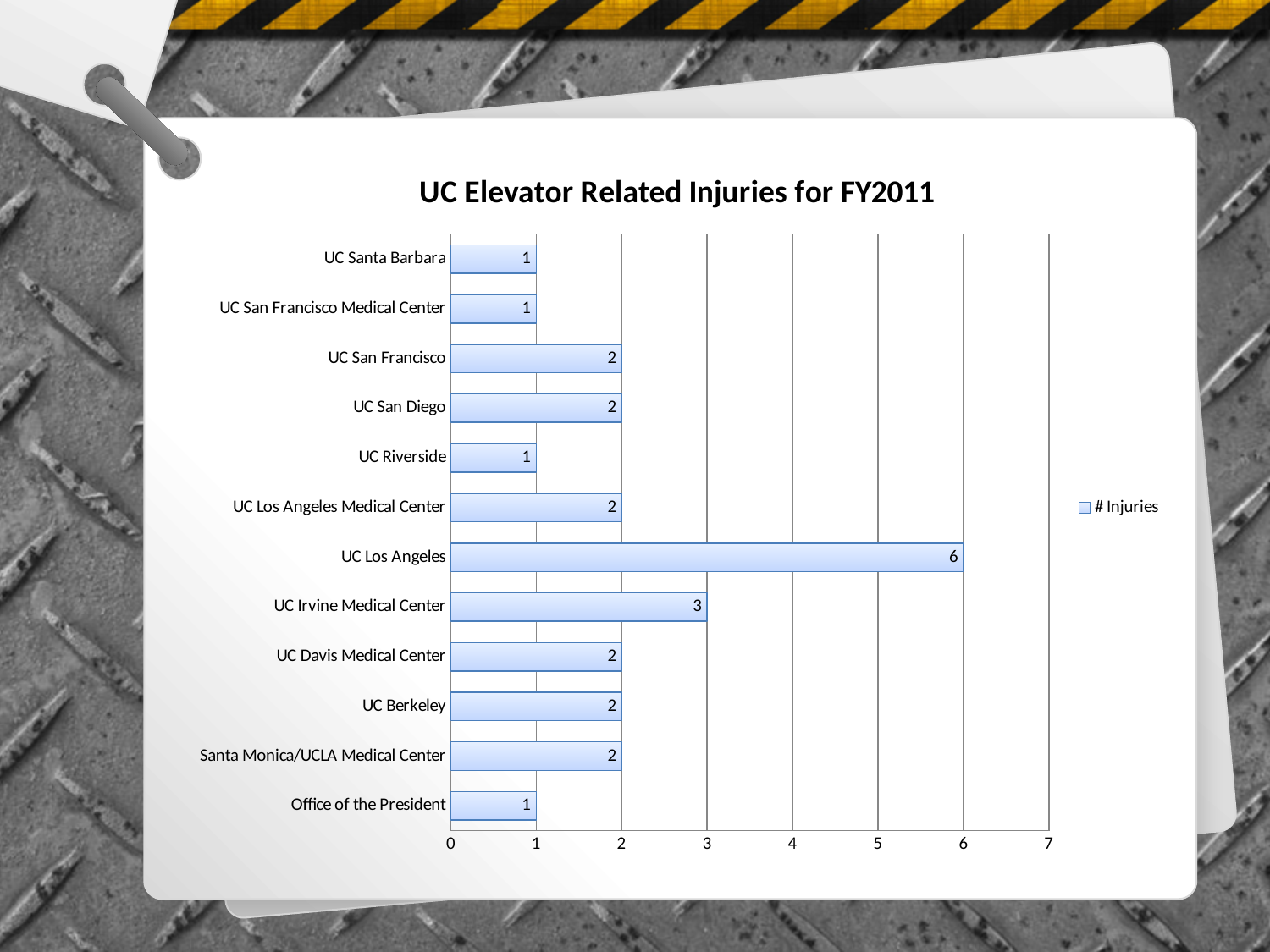
What kind of chart is shown on the slide? bar chart Which has more injuries, UC San Diego or UC Riverside? UC San Diego Is the value for UC Los Angeles greater or less than 5? greater What is the legend entry shown on the chart? # Injuries What is the difference in injuries between UC Los Angeles and UC Irvine Medical Center? 3 How many series does the legend list? 1 What is the number of injuries for Office of the President? 1 How many categories are shown on the chart? 12 What is the title of the chart? UC Elevator Related Injuries for FY2011 What is the number of injuries for UC Los Angeles? 6 Which category has the highest number of injuries? UC Los Angeles What is the number of injuries for UC Irvine Medical Center? 3